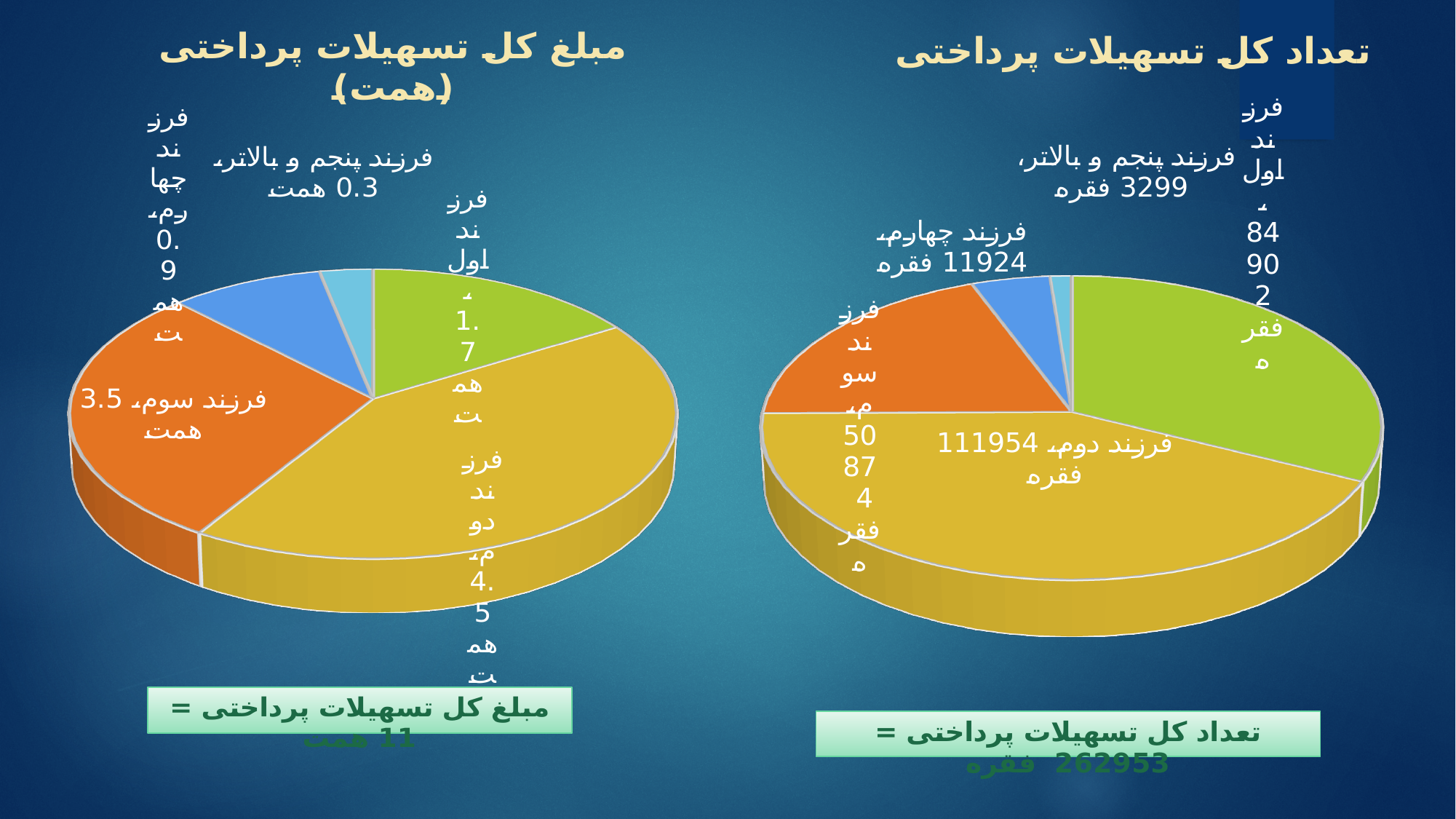
What kind of chart is used on this slide? Pie chart In the right-hand chart (تعداد کل تسهیلات پرداختی), what is the value for فرزند دوم? 111954 فقره In the right-hand chart (تعداد کل تسهیلات پرداختی), which category has the largest slice? فرزند دوم According to the text box under the right-hand chart, what is the total number of facilities paid (تعداد کل تسهیلات پرداختی)? 262953 فقره In the right-hand chart (تعداد کل تسهیلات پرداختی), which category has the smallest slice? فرزند پنجم و بالاتر In the right-hand chart (تعداد کل تسهیلات پرداختی), what is the value for فرزند چهارم? 11924 فقره In the left-hand chart (مبلغ کل تسهیلات پرداختی), which category has the largest slice? فرزند دوم In the left-hand chart (مبلغ کل تسهیلات پرداختی), what is the value for فرزند سوم? 3.5 همت In the left-hand chart (مبلغ کل تسهیلات پرداختی), which is larger, the value for فرزند اول or فرزند سوم? فرزند سوم In the left-hand chart (مبلغ کل تسهیلات پرداختی), what is the value for فرزند پنجم و بالاتر? 0.3 همت In the right-hand chart (تعداد کل تسهیلات پرداختی), how many categories are shown? 5 In the right-hand chart (تعداد کل تسهیلات پرداختی), what is the difference between the values for فرزند دوم and فرزند اول? 27052